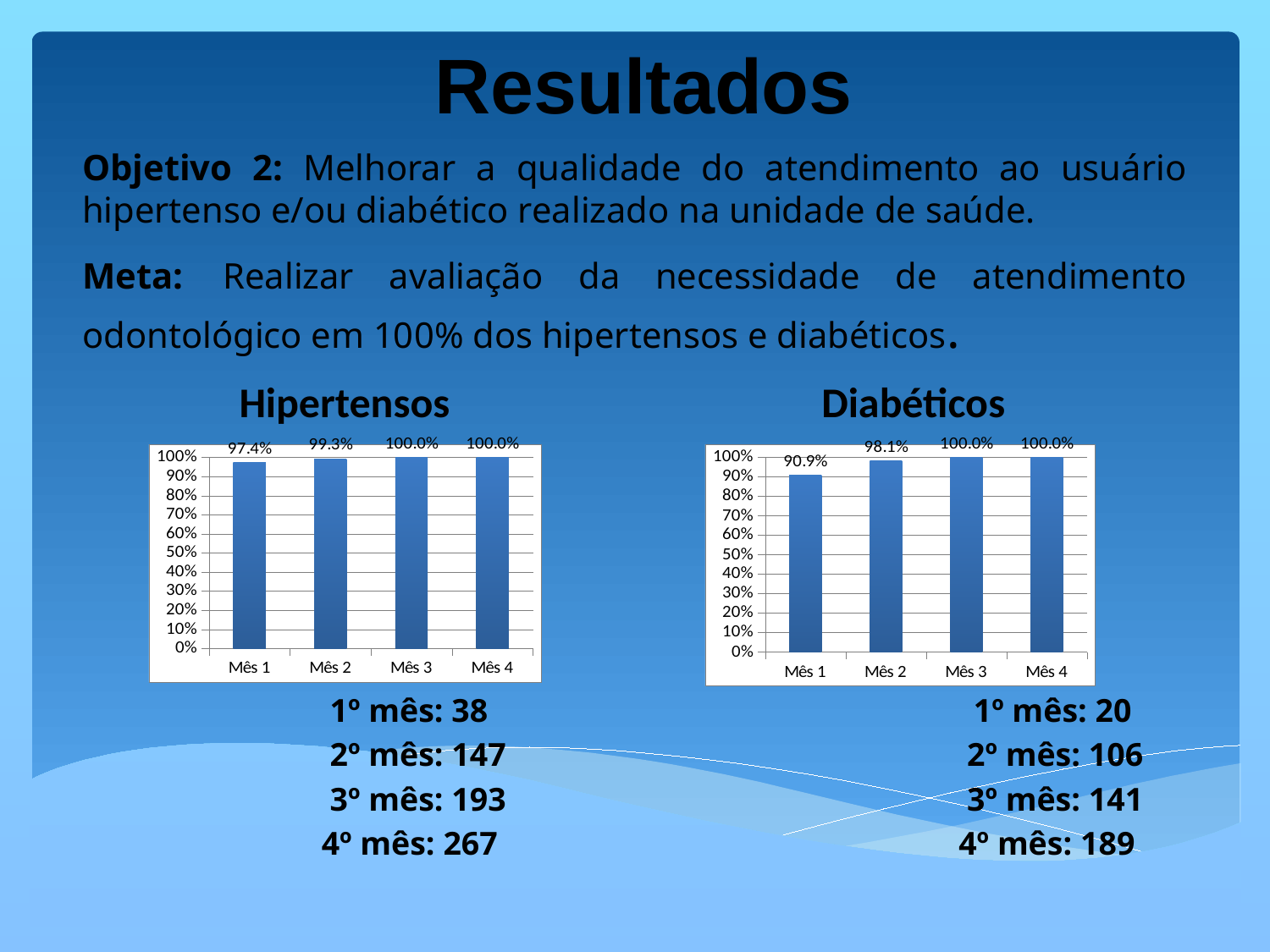
How many months are shown on the x axis of the Diabéticos chart? 4 In the Diabéticos chart, do the values rise or fall from Mês 1 to Mês 4? Rise In the Hipertensos chart, what is the value for Mês 1? 97.4% In the Diabéticos chart, what is the value for Mês 1? 90.9% In the Diabéticos chart, what is the value for Mês 2? 98.1% In the Hipertensos chart, what is the difference between the values for Mês 3 and Mês 1? 2.6% In the Diabéticos chart, what is the difference between the values for Mês 2 and Mês 1? 7.2% In the Diabéticos chart, which month has the lowest value? Mês 1 In the Hipertensos chart, what is the value for Mês 2? 99.3% In the Hipertensos chart, which month has the lowest value? Mês 1 Which is larger: the Mês 1 value in the Hipertensos chart or the Mês 1 value in the Diabéticos chart? Hipertensos What kind of chart is the Hipertensos chart? Bar chart